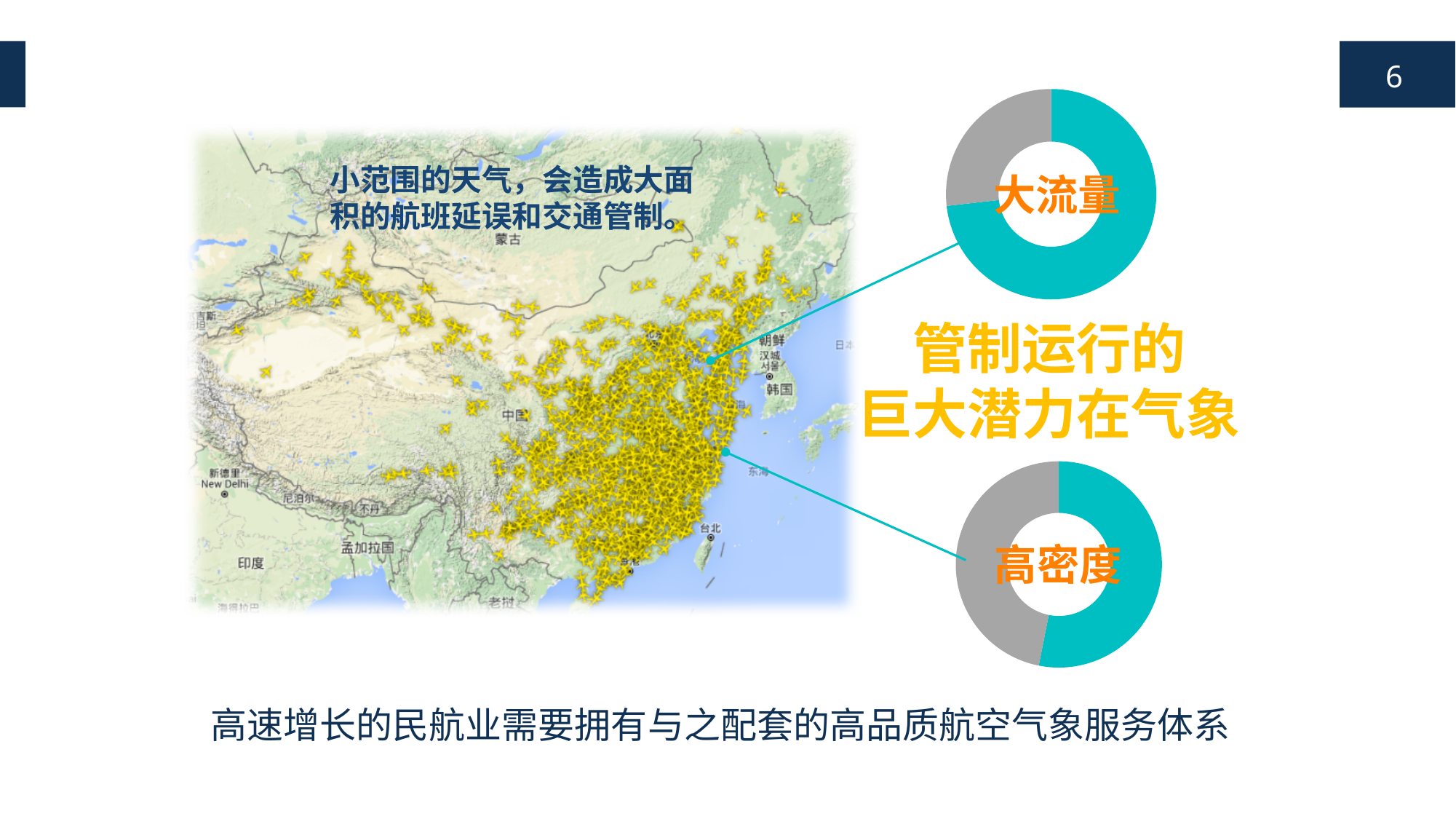
How many slices does the 高密度 donut chart have? 2 What label is printed in the centre of the lower donut chart? 高密度 In the 大流量 donut chart, which slice is larger, the teal one or the grey one? the teal one What label is printed in the centre of the upper donut chart? 大流量 How many slices does the 大流量 donut chart have? 2 What kind of chart is the chart labelled 大流量 at the top right of the slide? donut chart What kind of chart is the chart labelled 高密度 at the bottom right of the slide? donut chart In the 高密度 donut chart, which slice is larger, the teal one or the grey one? the teal one